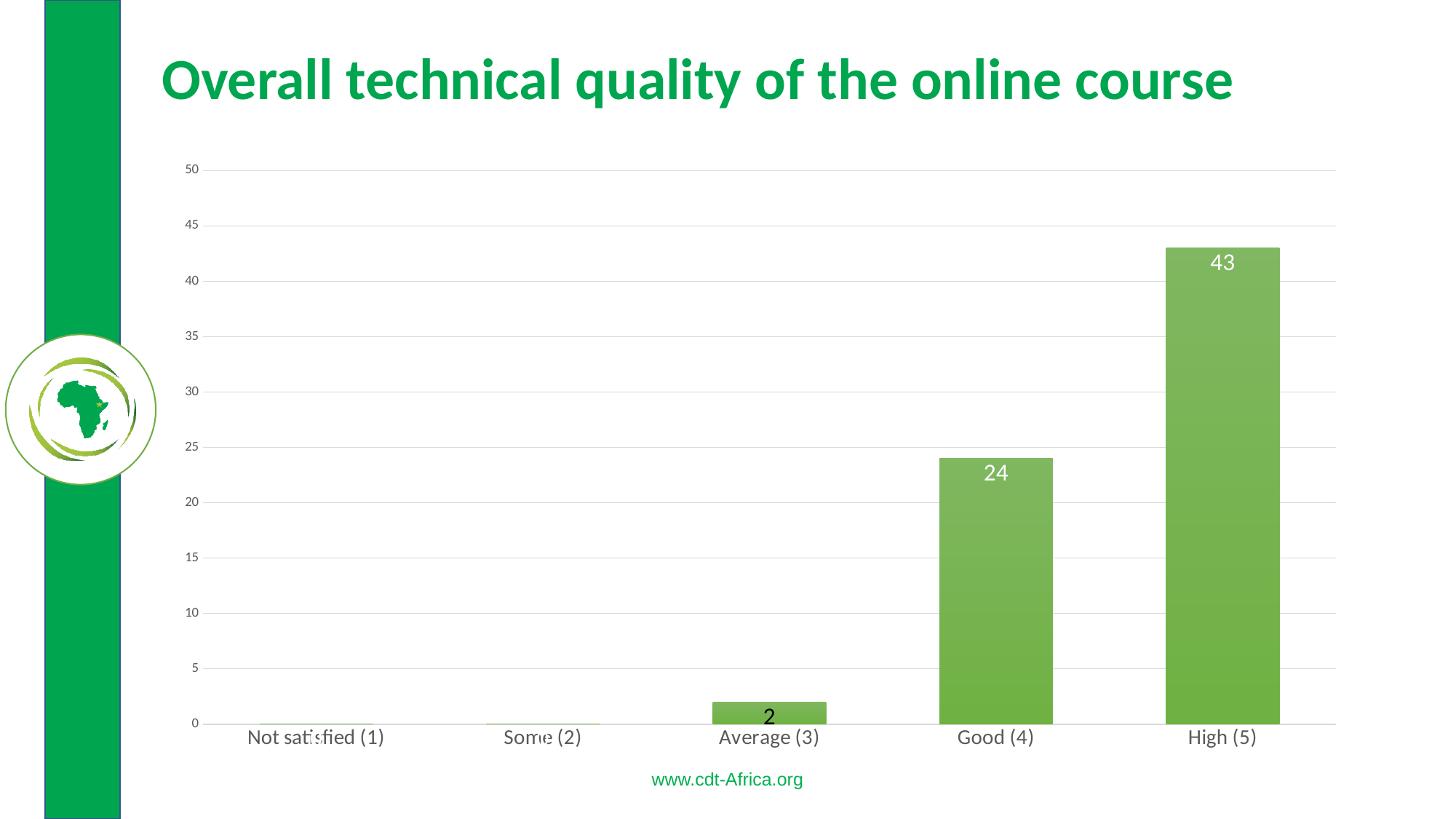
Which category has the highest value? High (5) What is the value for High (5)? 43 What is the value for Good (4)? 24 What kind of chart is shown on the slide? bar chart What is the difference between the values for Good (4) and Average (3)? 22 What is the value for Average (3)? 2 What is the difference between the values for High (5) and Good (4)? 19 Which is larger, the value for Good (4) or the value for Average (3)? Good (4) Is the value for Some (2) greater or less than 5? less What is the title of the slide? Overall technical quality of the online course Is the value for High (5) greater or less than 40? greater How many categories are shown on the x axis? 5